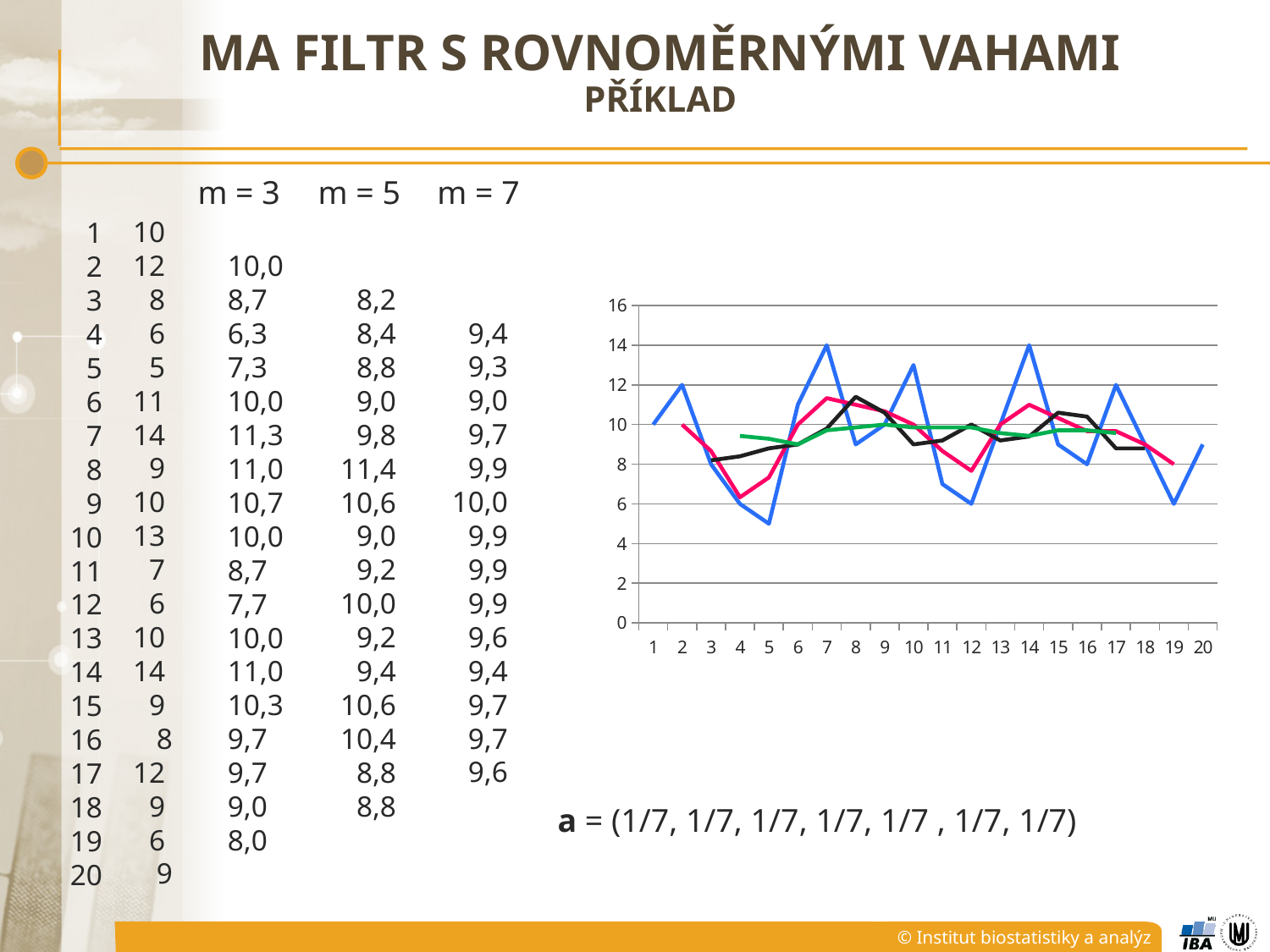
Is the value of the green line at x = 10 greater or less than 8? greater How many points are labelled along the x axis of the chart? 20 At x = 7, which line has the larger value, the blue line or the red line? blue line What is the value of the blue line at x = 1? 10 What is the value of the blue line at x = 12? 6 At which x value does the blue line reach its lowest point? 5 Is the value of the red line at x = 4 greater or less than 8? less What kind of chart is shown on the slide? line chart How many lines are plotted on the chart? 4 Does the blue line rise or fall from x = 14 to x = 16? fall What is the highest value the blue line reaches on the chart? 14 What is the highest tick value shown on the y axis of the chart? 16